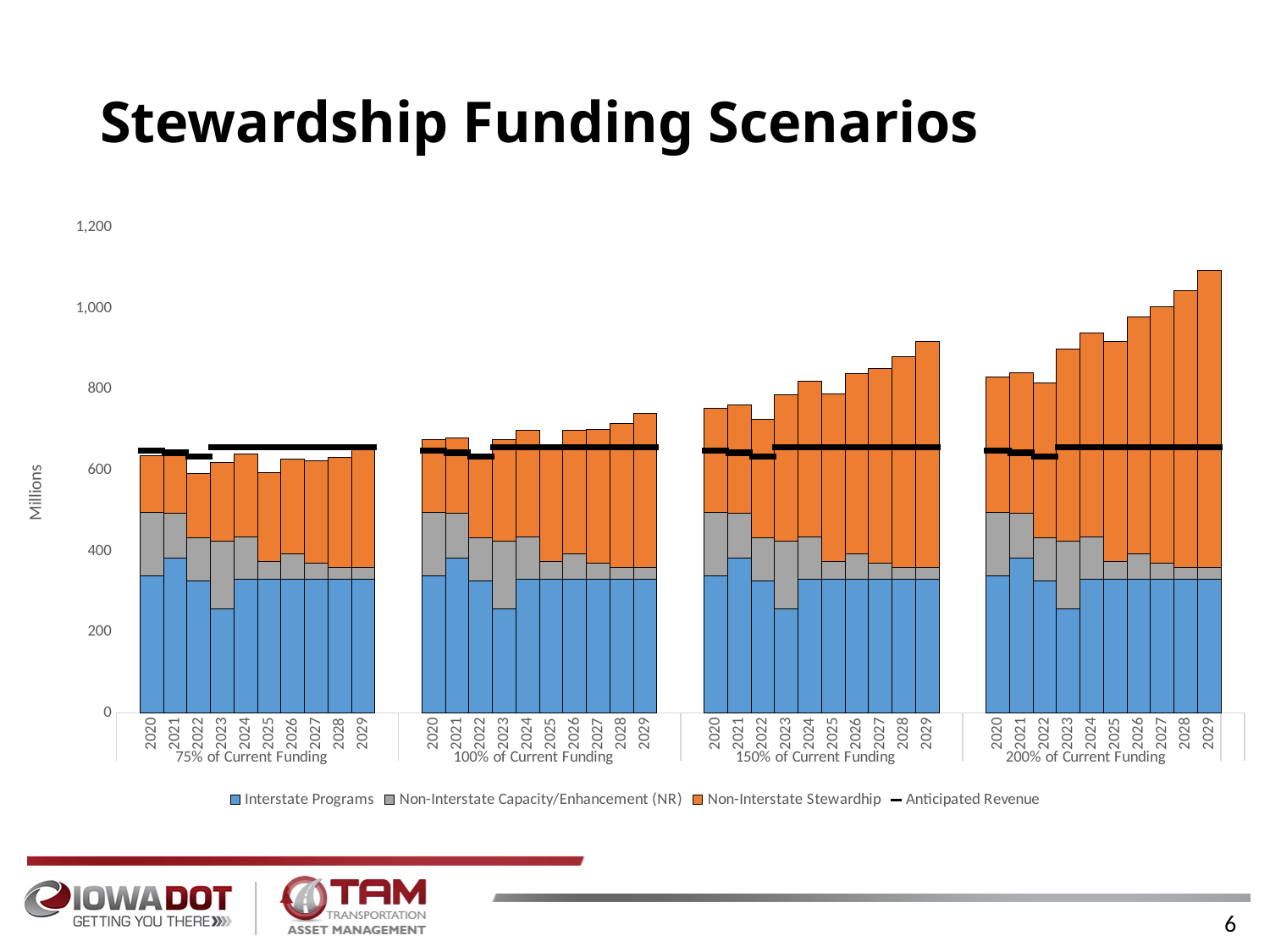
Is the total stacked value for 2029 under 150% of Current Funding greater or less than 800? greater How many funding scenario groups are shown along the x axis? 4 Is the total stacked value for 2023 under 75% of Current Funding greater or less than 800? less Within the 150% of Current Funding group, do the total stacked values generally rise or fall from 2020 to 2029? rise Within the 200% of Current Funding group, which year has the highest total stacked value? 2029 Which legend entry is shown as a black line rather than a bar segment? Anticipated Revenue Is the total stacked value for 2029 under 200% of Current Funding greater or less than 1,000? greater How many years are plotted within each funding scenario group? 10 How many series does the legend list? 4 What is the title of the chart on the slide? Stewardship Funding Scenarios What kind of chart is shown on the slide? Stacked bar chart with a line (Anticipated Revenue) overlaid Which is larger: the total stacked value for 2029 under 75% of Current Funding or for 2029 under 200% of Current Funding? 2029 under 200% of Current Funding